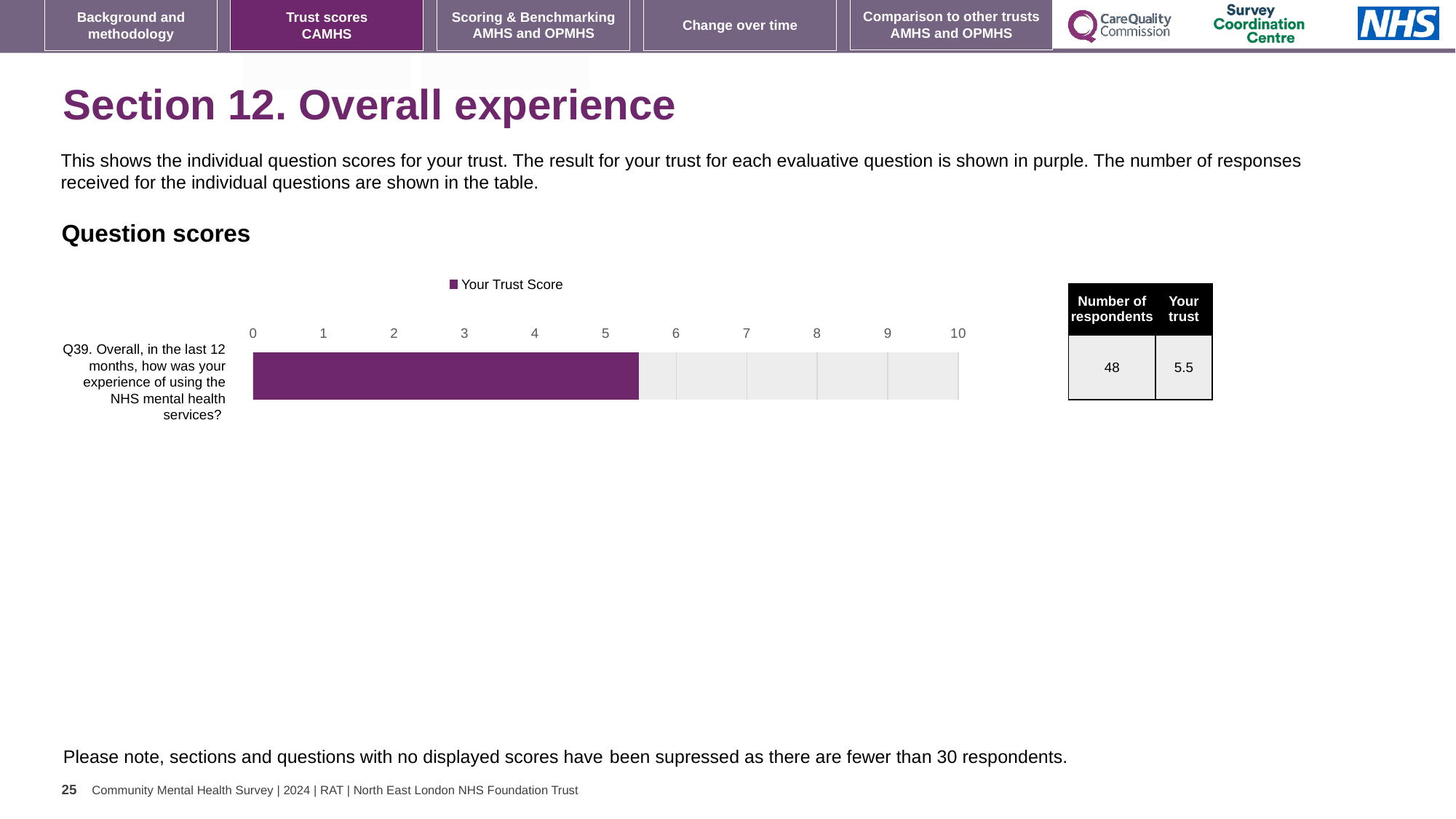
What is the legend entry shown above the Question scores chart? Your Trust Score What kind of chart is shown under 'Question scores'? bar chart Is the trust score for Q39 greater or less than 8? less Is the trust score for Q39 greater or less than 6? less Is the trust score for Q39 greater or less than 5? greater How many series does the legend of the Question scores chart list? 1 How many respondents answered Q39, according to the table next to the chart? 48 What is the trust score for Q39, as shown in the 'Your trust' column of the table? 5.5 How many questions (categories) are plotted in the Question scores chart? 1 What is the highest value shown on the x axis of the Question scores chart? 10